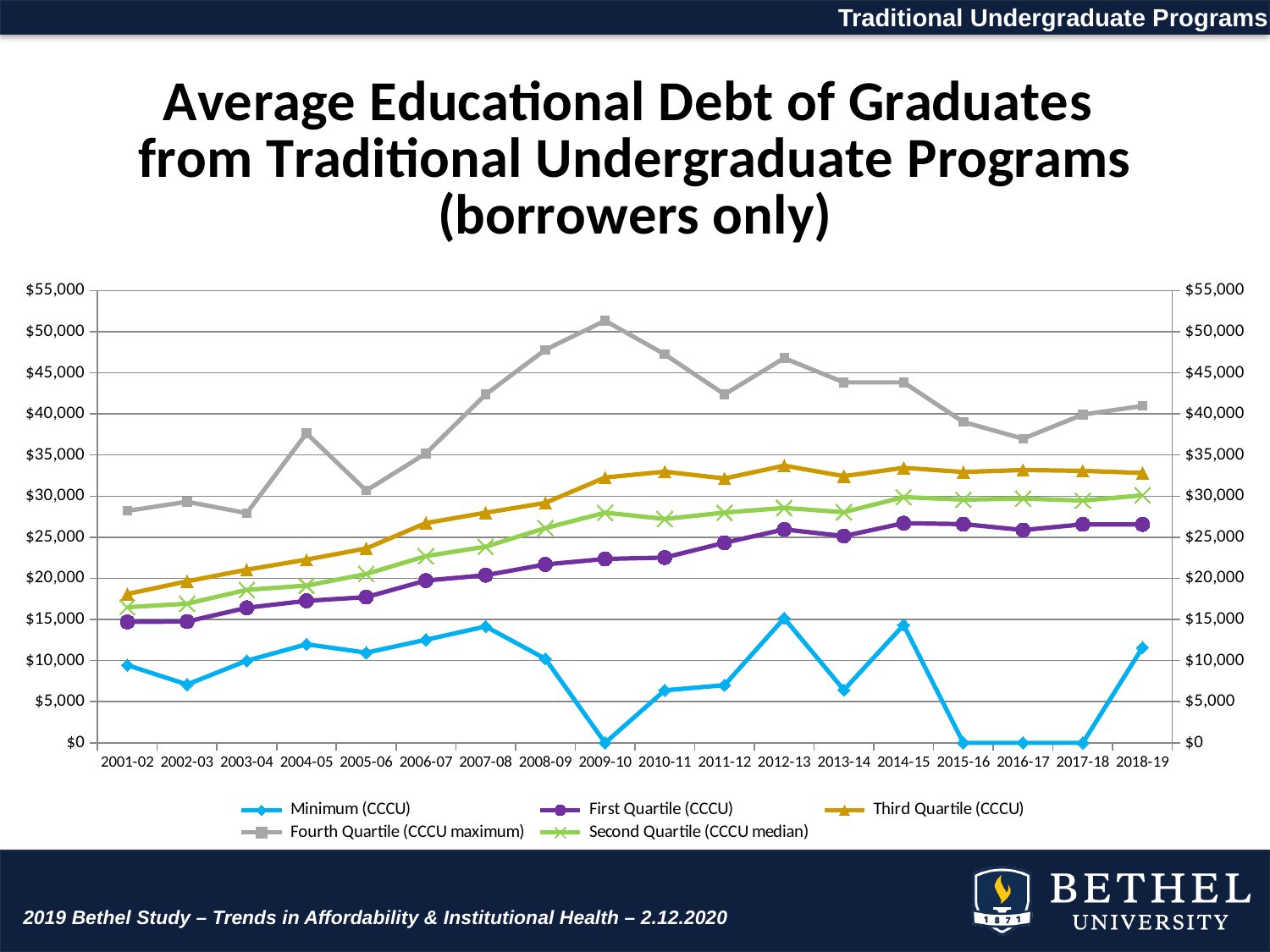
Which is larger for the Fourth Quartile (CCCU maximum) series: the value for 2004-05 or the value for 2005-06? 2004-05 In which academic year does the Fourth Quartile (CCCU maximum) series reach its highest value? 2009-10 What kind of chart is shown on the slide? line chart Is the Third Quartile (CCCU) value for 2001-02 greater or less than $20,000? less Which legend entry corresponds to the gray line with square markers? Fourth Quartile (CCCU maximum) Is the Fourth Quartile (CCCU maximum) value for 2009-10 greater or less than $50,000? greater How many series does the legend list? 5 What is the Minimum (CCCU) value for 2009-10? $0 How many academic years are plotted along the x axis? 18 In which academic year is the Third Quartile (CCCU) series at its lowest? 2001-02 Does the Third Quartile (CCCU) series rise or fall from 2001-02 to 2009-10? rise Is the First Quartile (CCCU) value for 2018-19 greater or less than $25,000? greater